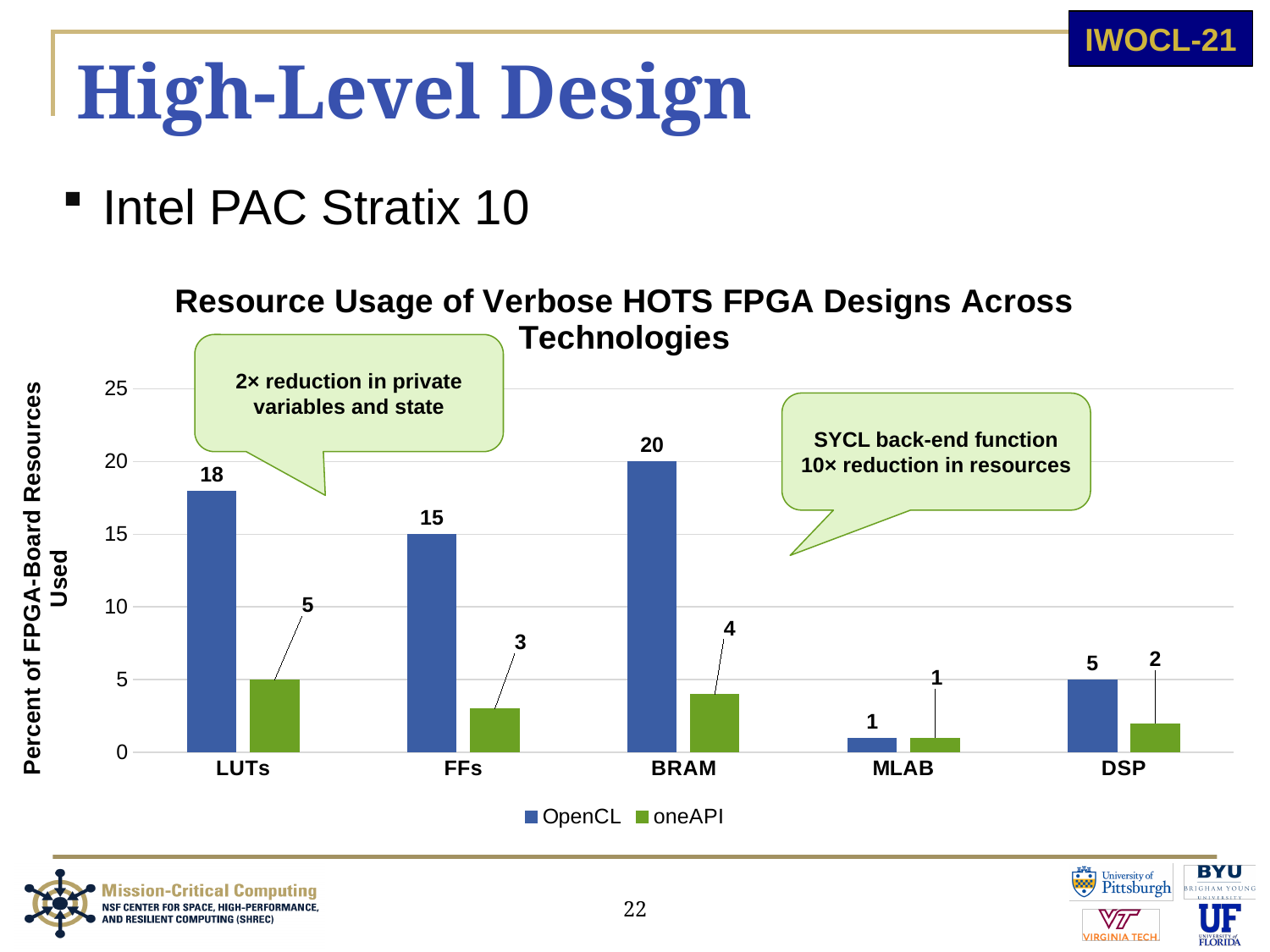
Which category has the lowest oneAPI value? MLAB How many categories are shown on the x axis? 5 What is the OpenCL value for FFs? 15 What is the oneAPI value for DSP? 2 Which category has the highest OpenCL value? BRAM What kind of chart is shown on the slide? bar chart What is the oneAPI value for LUTs? 5 How many series does the legend list? 2 Which is larger for FFs, the OpenCL value or the oneAPI value? OpenCL What is the OpenCL value for BRAM? 20 What is the title of the chart? Resource Usage of Verbose HOTS FPGA Designs Across Technologies What is the difference between the OpenCL and oneAPI values for BRAM? 16